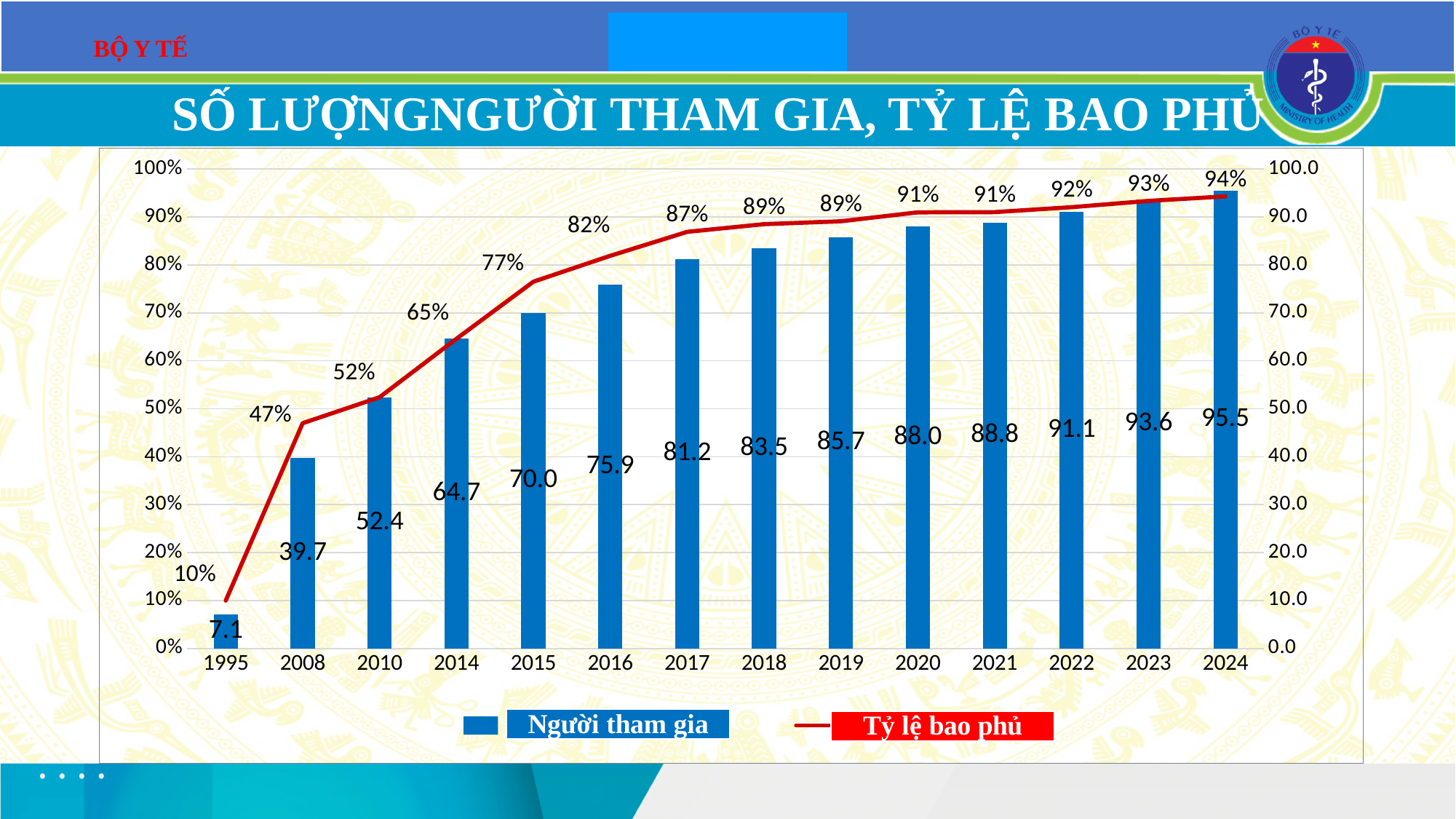
Which is larger, the Người tham gia value for 2016 or for 2015? 2016 How many series does the legend list? 2 Which series is drawn as a red line? Tỷ lệ bao phủ How many years are shown on the x axis? 14 What is the difference between the Người tham gia values for 2024 and 2023? 1.9 What is the Tỷ lệ bao phủ value for 2017? 87% What is the value of Người tham gia for 2024? 95.5 Which year has the highest Tỷ lệ bao phủ value? 2024 What kind of chart is shown on the slide? Combined bar and line chart Do the Tỷ lệ bao phủ values rise or fall from 1995 to 2024? Rise Which year has the lowest Người tham gia value? 1995 What is the value of Người tham gia for 1995? 7.1